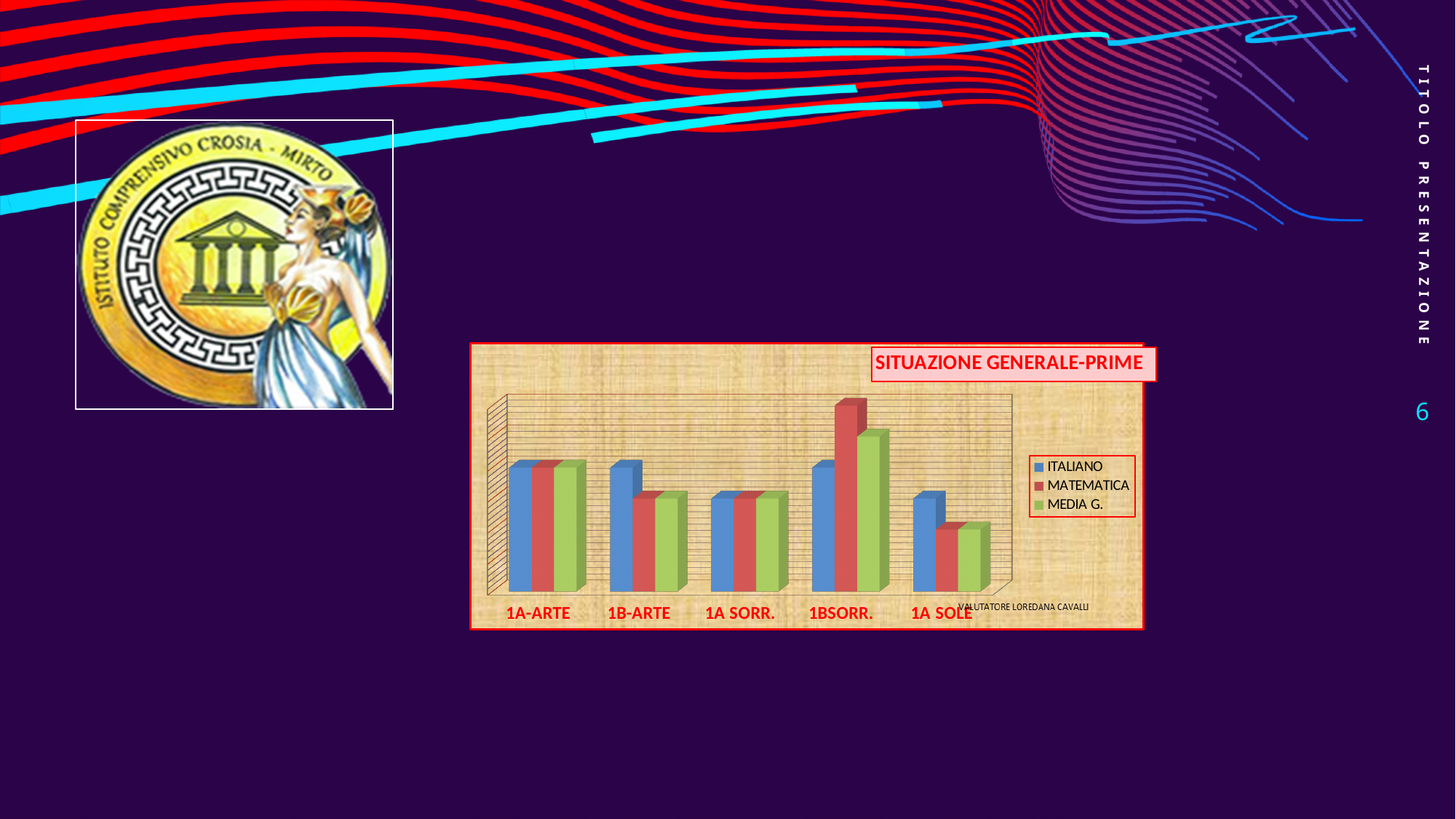
Which colour represents the MATEMATICA series in the legend? red For 1B-ARTE, which is larger: ITALIANO or MATEMATICA? ITALIANO For 1BSORR., which is larger: ITALIANO or MATEMATICA? MATEMATICA Which category has the highest MEDIA G. bar? 1BSORR. Which category has the lowest MATEMATICA bar? 1A SOLE What is the title of the chart? SITUAZIONE GENERALE-PRIME How many categories are shown on the x axis of the chart? 5 For 1A SOLE, which is larger: ITALIANO or MEDIA G.? ITALIANO What kind of chart is shown on the slide? bar chart How many series does the chart legend list? 3 Which category has the highest MATEMATICA bar? 1BSORR. Which category has the lowest ITALIANO bar? 1A SORR. and 1A SOLE (tied)